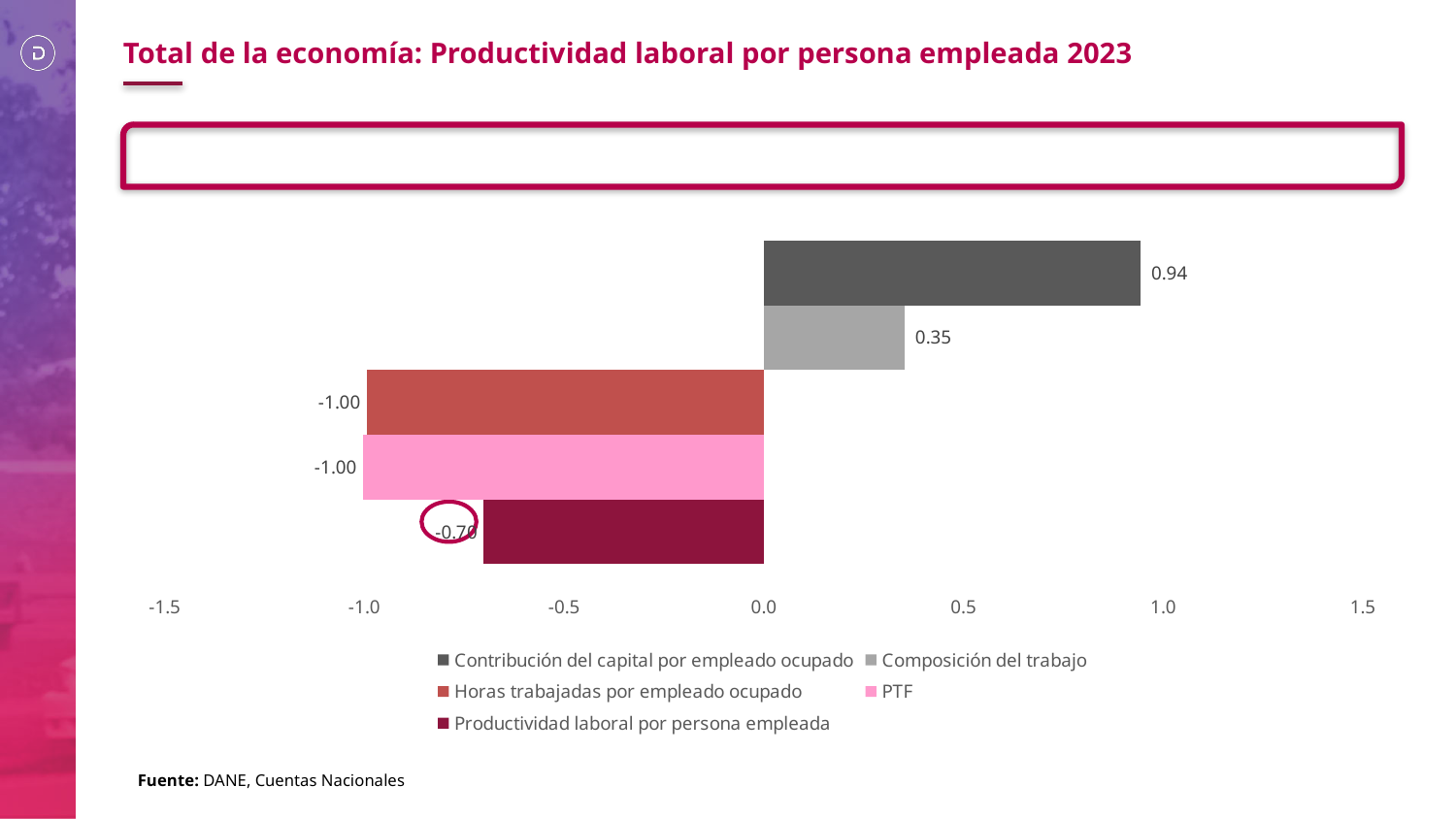
What is the value of the Contribución del capital por empleado ocupado bar? 0.94 What is the difference between the Contribución del capital por empleado ocupado value and the Composición del trabajo value? 0.59 Which is larger, the value for Contribución del capital por empleado ocupado or the value for Composición del trabajo? Contribución del capital por empleado ocupado What is the value of the PTF bar? -1.00 How many bars are plotted in the chart? 5 What kind of chart is shown on the slide? Bar chart Is the value for Productividad laboral por persona empleada greater or less than -0.5? less What is the value of the Horas trabajadas por empleado ocupado bar? -1.00 What is the value of the Composición del trabajo bar? 0.35 What is the title of the chart on the slide? Total de la economía: Productividad laboral por persona empleada 2023 Which series has the highest value in the chart? Contribución del capital por empleado ocupado How many series does the legend list? 5